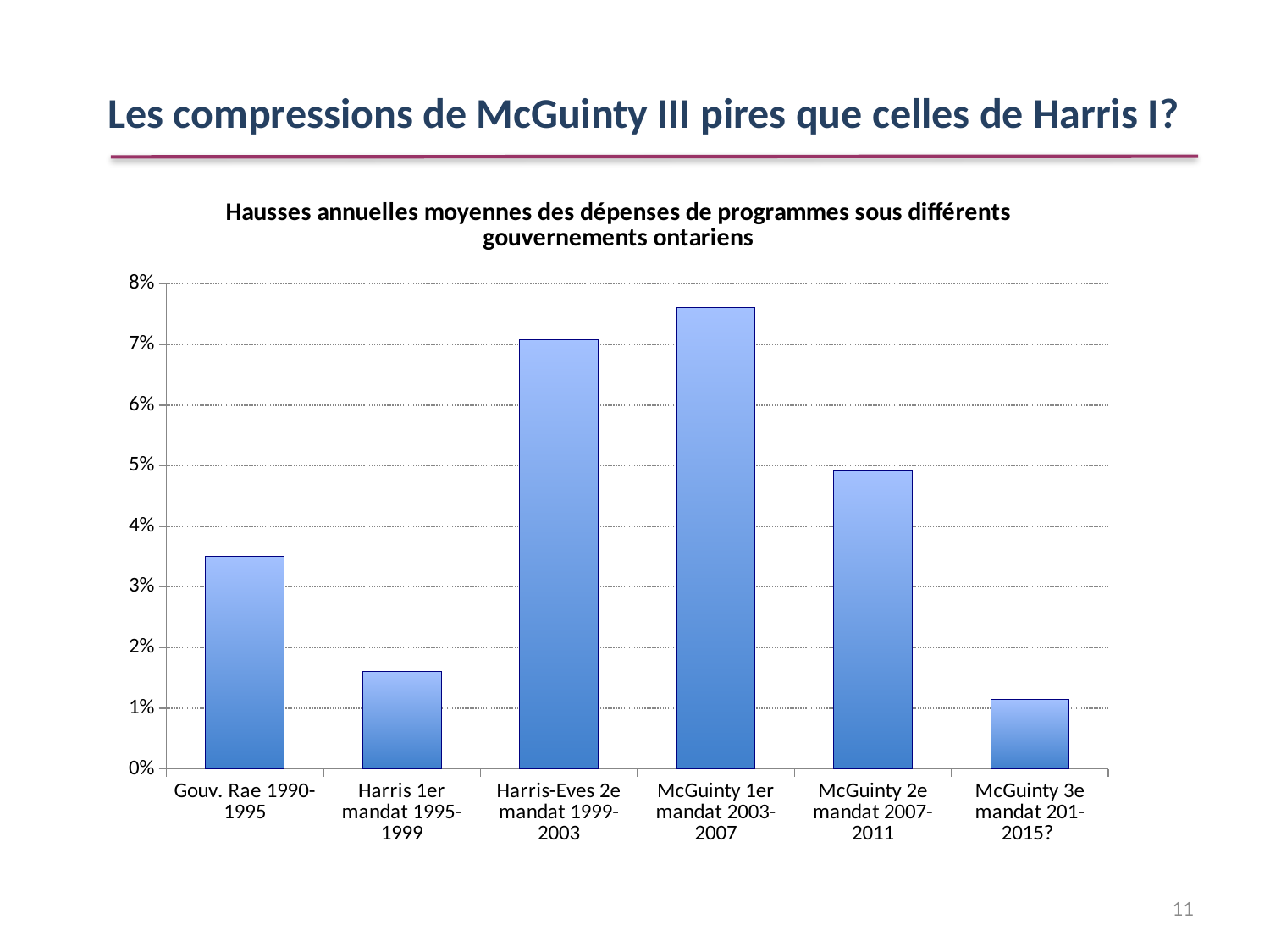
Which is larger: the value for Harris 1er mandat 1995-1999 or the value for McGuinty 3e mandat 201-2015? Harris 1er mandat 1995-1999 What kind of chart is shown on the slide? Bar chart Which government has the lowest average annual increase in program spending? McGuinty 3e mandat 201-2015? How many governments (categories) are plotted on the chart? 6 Which is larger: the value for Gouv. Rae 1990-1995 or the value for McGuinty 2e mandat 2007-2011? McGuinty 2e mandat 2007-2011 What is the title of the chart? Hausses annuelles moyennes des dépenses de programmes sous différents gouvernements ontariens Is the value for Harris 1er mandat 1995-1999 greater or less than 2%? less Which government has the highest average annual increase in program spending? McGuinty 1er mandat 2003-2007 Is the value for McGuinty 3e mandat 201-2015? greater or less than 1%? greater Is the value for Gouv. Rae 1990-1995 greater or less than 3%? greater